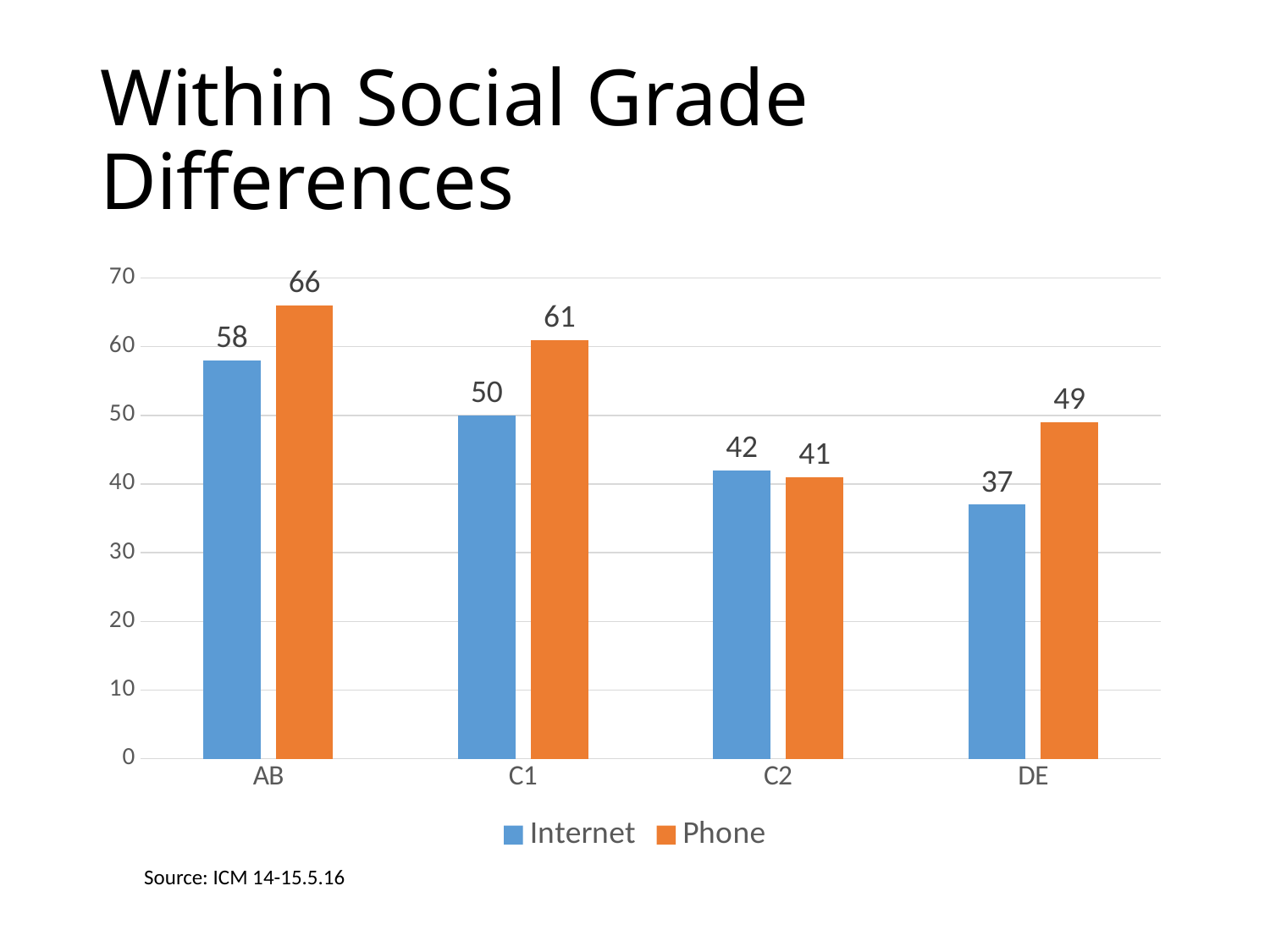
What kind of chart is shown on the slide? Bar chart How many categories are shown on the x axis? 4 What is the Internet value for AB? 58 What is the difference between the Internet values for C1 and DE? 13 What is the Phone value for C1? 61 What is the difference between the Phone and Internet values for AB? 8 Which is larger for C2, the Internet value or the Phone value? Internet What is the Phone value for DE? 49 Which category has the lowest Internet value? DE Which category has the highest Phone value? AB Do the Internet values rise or fall from AB to DE? Fall How many series does the legend list? 2